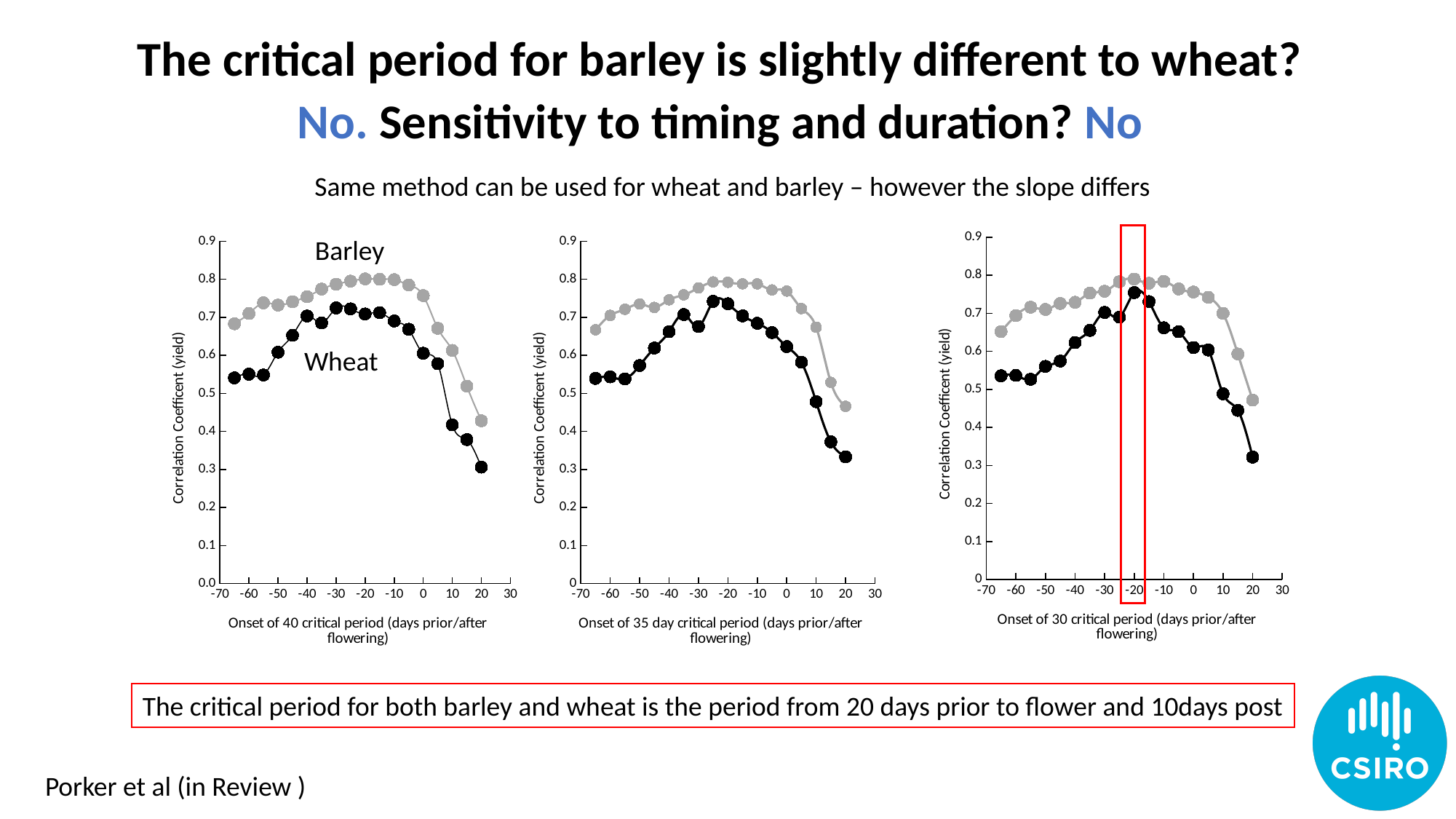
On the right chart (Onset of 30 critical period), at 20 days, which series has the higher value, the grey series or the black series? the grey series On the left chart (Onset of 40 critical period), how many series are plotted? 2 On the right chart (Onset of 30 critical period), is the Barley value at -65 days greater or less than 0.6? greater On the left chart (Onset of 40 critical period), is the Barley value at 20 days greater or less than 0.5? less What kind of chart is the left chart, titled 'Onset of 40 critical period'? line chart On the left chart (Onset of 40 critical period), does the Wheat series rise or fall between 0 and 20 days? fall On the left chart (Onset of 40 critical period), which series is drawn in grey? Barley On the left chart (Onset of 40 critical period), is the Wheat value at -65 days greater or less than 0.5? greater What is the y-axis title of the middle chart (Onset of 35 day critical period)? Correlation Coefficient (yield) On the middle chart (Onset of 35 day critical period), does the grey series rise or fall between -65 and -25 days? rise On the left chart (Onset of 40 critical period), at -20 days, which series has the higher correlation coefficient, Barley or Wheat? Barley